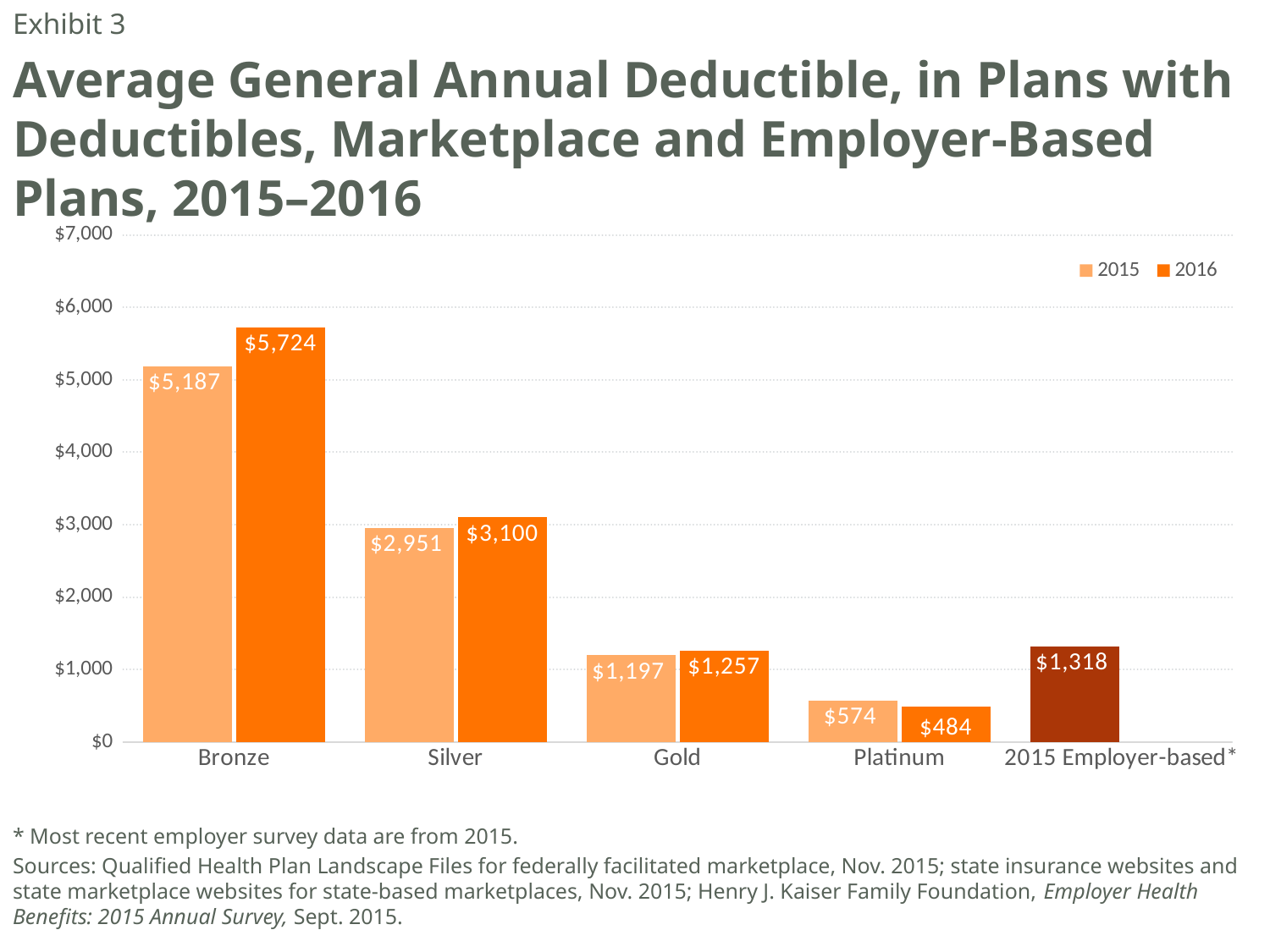
Is the 2016 Silver deductible greater or less than $3,000? greater What is the difference between the 2016 and 2015 average deductibles for Bronze plans? $537 What is the 2016 average deductible for Bronze plans? $5,724 What is the 2016 average deductible for Platinum plans? $484 Which is larger: the 2016 Gold deductible or the 2015 Employer-based deductible? 2015 Employer-based Which metal tier has the highest 2016 average deductible? Bronze How many series does the legend list? 2 Which metal tier has the lowest 2015 average deductible? Platinum What is the 2015 average deductible for Silver plans? $2,951 What kind of chart is shown on the slide? Bar chart What is the difference between the 2015 and 2016 average deductibles for Platinum plans? $90 What is the average deductible shown for 2015 Employer-based plans? $1,318